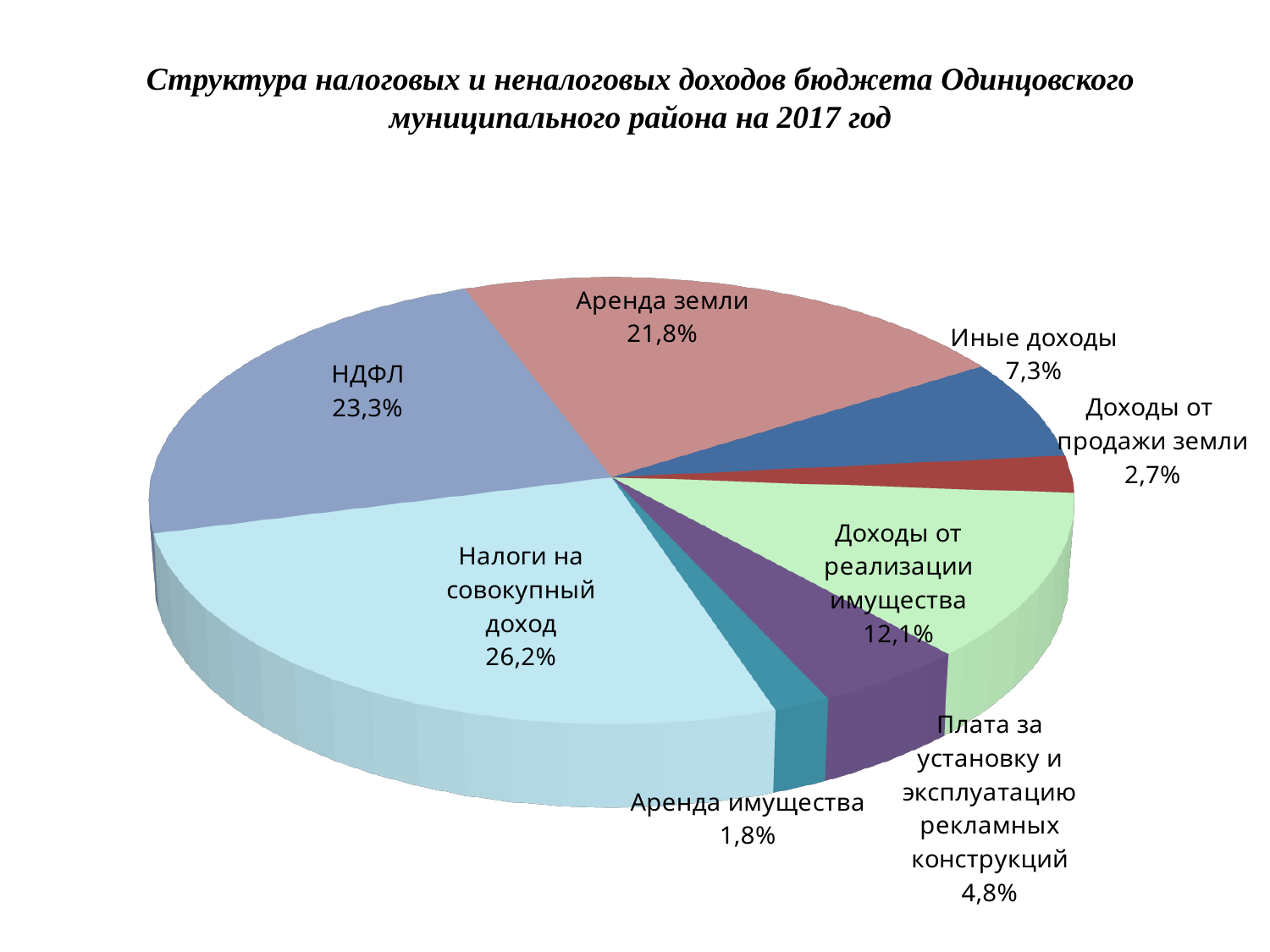
What is the difference between the shares of Налоги на совокупный доход and НДФЛ? 2,9% Which is larger, the share of Иные доходы or the share of Доходы от продажи земли? Иные доходы How many slices does the pie chart have? 8 What year does the chart title refer to? 2017 What share does НДФЛ have in the pie chart? 23,3% What percentage is shown for Доходы от реализации имущества? 12,1% What is the value shown for Аренда земли? 21,8% What is the combined share of Аренда земли and Аренда имущества? 23,6% What kind of chart is shown on the slide? Pie chart Which category has the largest share of the pie? Налоги на совокупный доход Which category has the smallest share of the pie? Аренда имущества What is the value for Плата за установку и эксплуатацию рекламных конструкций? 4,8%